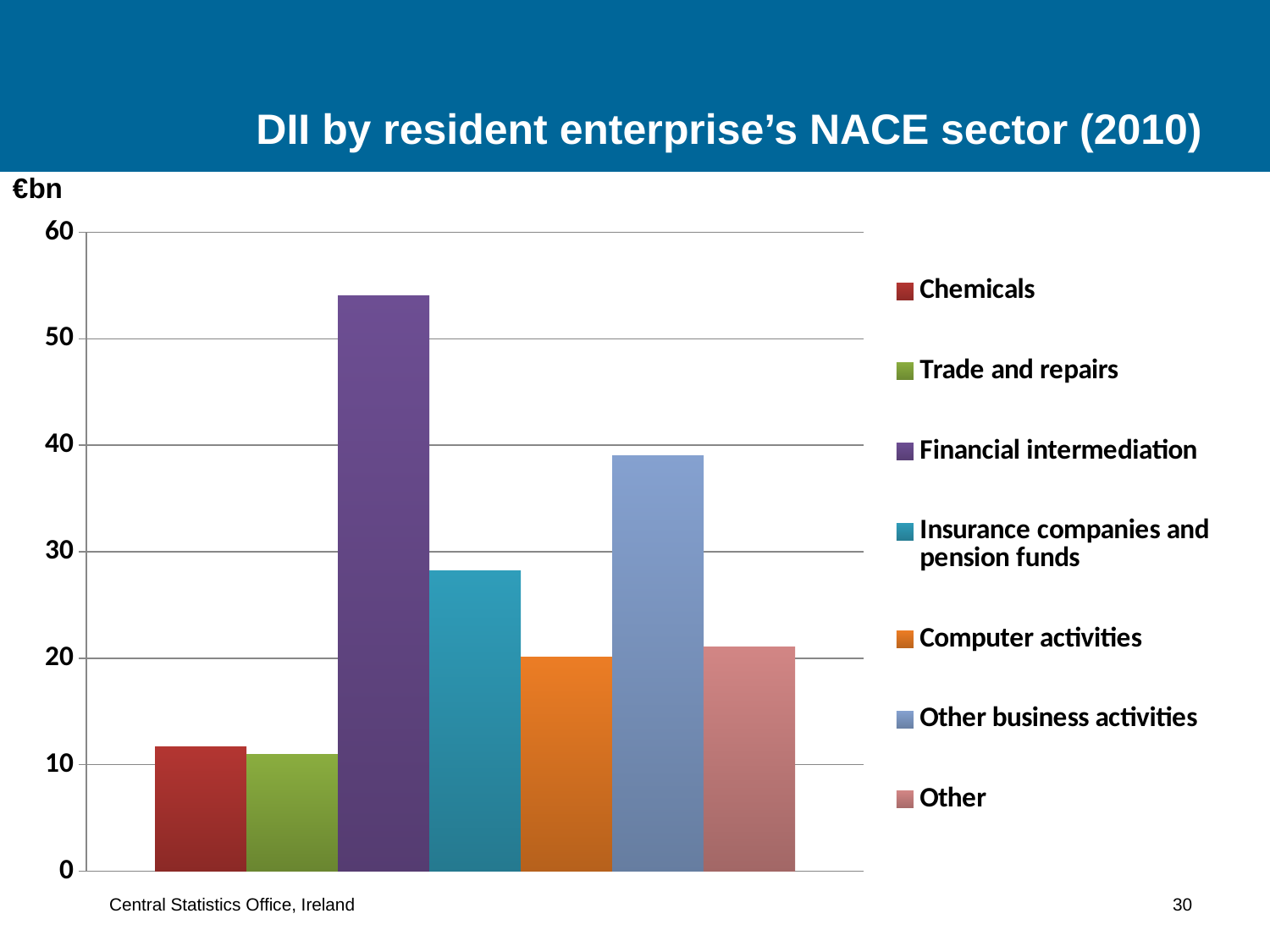
How many bars are plotted in the chart? 7 What type of chart is shown on the slide? Bar chart Is the value for Chemicals greater or less than 10? greater How many entries does the legend list? 7 Is the value for Financial intermediation greater or less than 50? greater What is the title of the chart? DII by resident enterprise's NACE sector (2010) Is the value for Other business activities greater or less than 30? greater Which is larger, the value for Financial intermediation or the value for Other business activities? Financial intermediation Which is larger, the value for Insurance companies and pension funds or the value for Computer activities? Insurance companies and pension funds What unit is shown on the vertical axis of the chart? €bn Which sector has the highest DII value? Financial intermediation